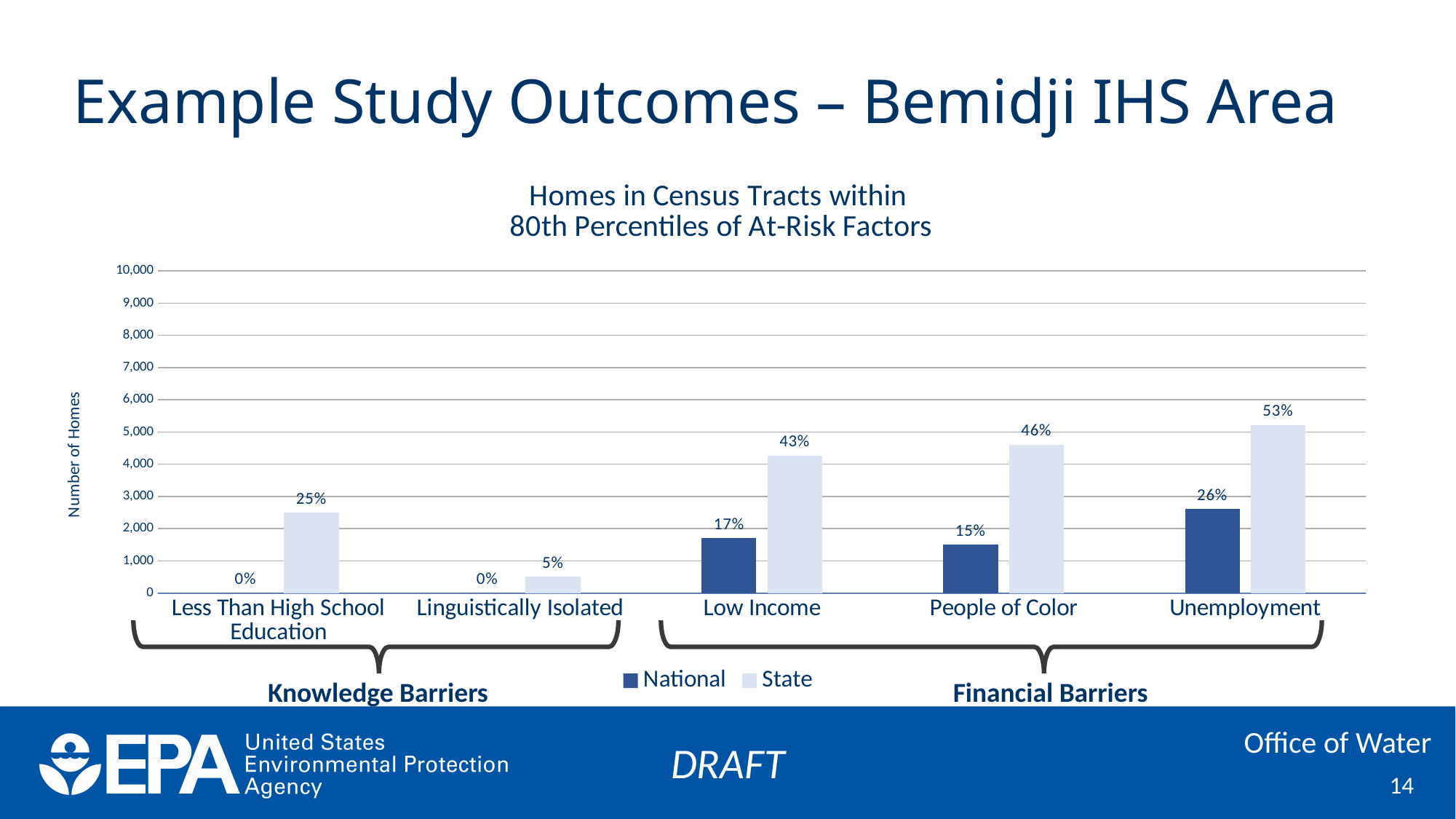
Which is larger for People of Color, the National bar or the State bar? State What is the difference between the percentage labels on the State and National bars for Unemployment? 27 percentage points What percentage label is shown on the State bar for Unemployment? 53% How many categories are shown on the x axis? 5 What percentage label is shown on the State bar for Linguistically Isolated? 5% What kind of chart is shown on the slide? Bar chart Which category has the tallest State bar? Unemployment How many series does the legend list? 2 Is the State bar for Linguistically Isolated greater or less than 1,000 homes? less Which category has the shortest State bar? Linguistically Isolated Is the State bar for Unemployment greater or less than 5,000 homes? greater What percentage label is shown on the National bar for Low Income? 17%